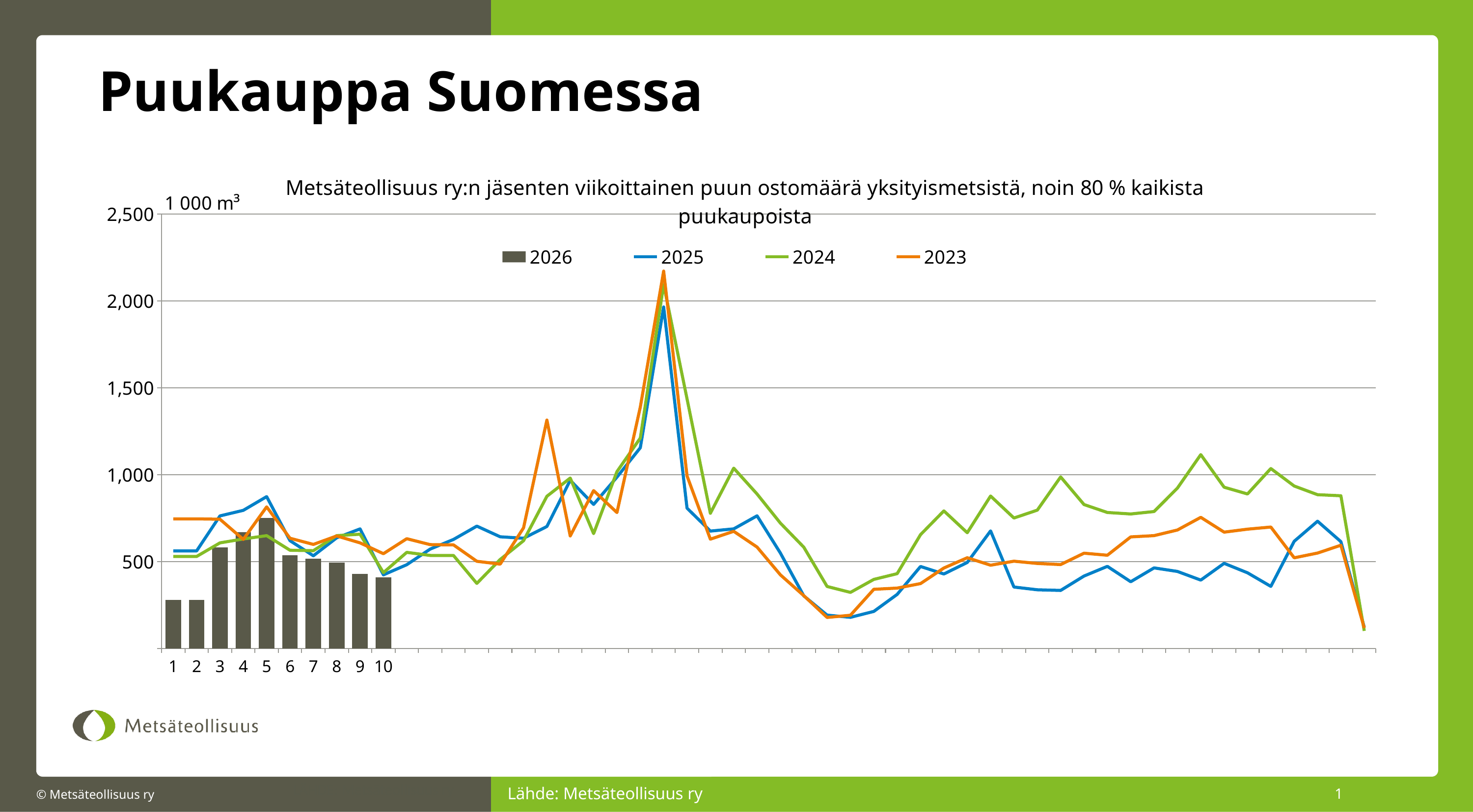
Is the 2026 value for week 1 greater or less than 500? less Which is larger, the 2026 bar for week 5 or the 2026 bar for week 10? Week 5 Is the 2026 value for week 10 greater or less than 500? less Which series is shown as bars rather than a line? 2026 How many series does the legend list? 4 What kind of chart is this? A combination of a bar chart (2026) and line chart (2025, 2024, 2023) What unit is shown on the vertical axis? 1 000 m³ Is the highest peak of the 2023 line greater or less than 2,000? greater How many bars are plotted for the 2026 series? 10 Do the 2026 bars rise or fall from week 5 to week 10? fall Which week has the highest 2026 bar? 5